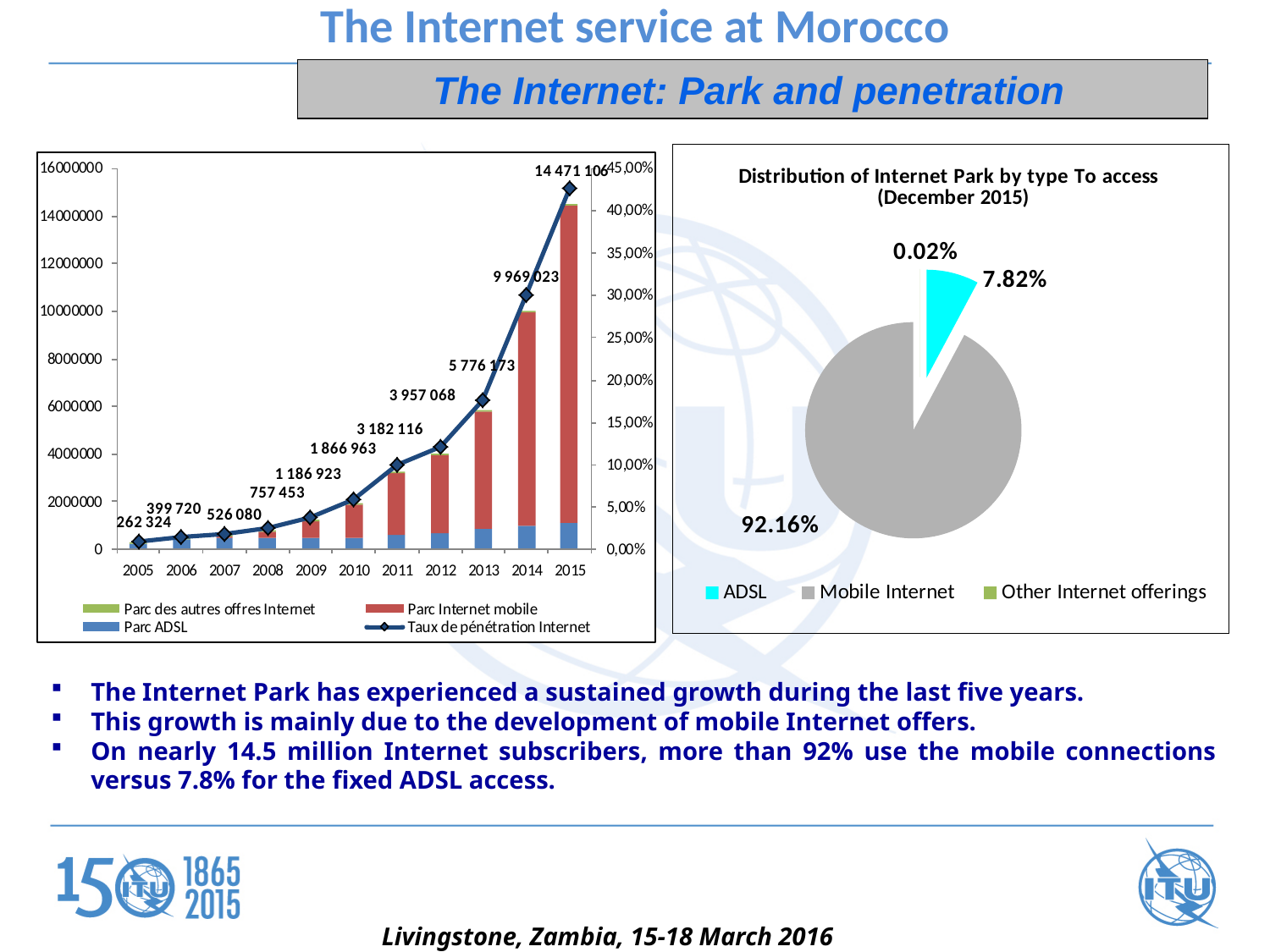
In the left chart, what is the difference between the labelled values for 2015 and 2014? 4 502 083 In the left chart, what is the labelled value for 2005? 262 324 In the left chart, how many years are shown on the x axis? 11 In the left chart, do the labelled values rise or fall from 2005 to 2015? rise In the left chart, what is the labelled value for 2015? 14 471 106 In the left chart, how many series does the legend list? 4 In the left chart, which year has the lowest labelled value? 2005 In the pie chart 'Distribution of Internet Park by type To access (December 2015)', which category has the smallest share? Other Internet offerings In the left chart, which year has the highest labelled value? 2015 In the left chart, is the Taux de pénétration Internet value for 2015 greater or less than 40,00%? greater In the pie chart 'Distribution of Internet Park by type To access (December 2015)', what share does Mobile Internet have? 92.16% In the left chart, what is the labelled value for 2010? 1 866 963